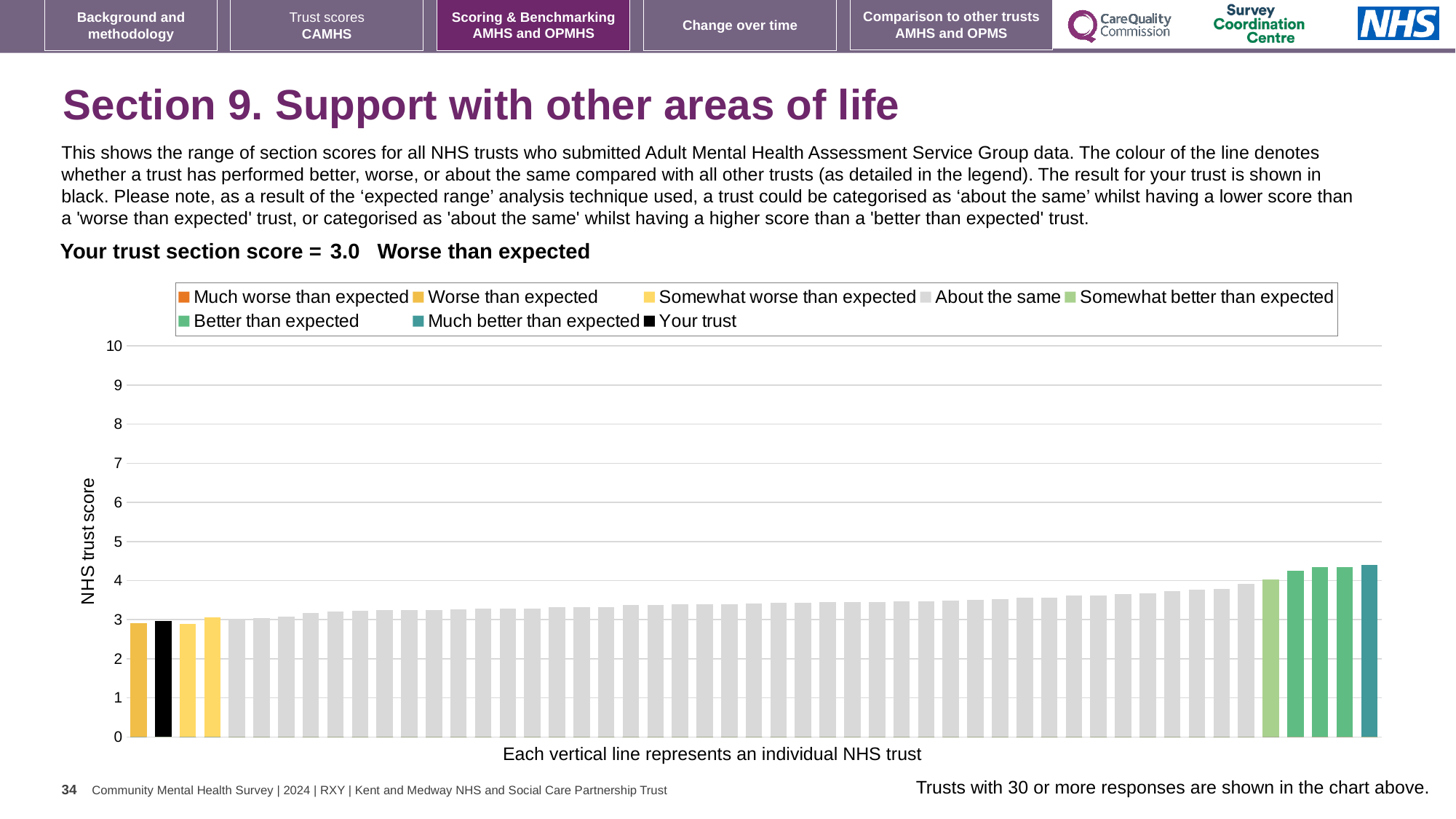
How many bars are shown in the 'Much worse than expected' colour? 0 Is the value for 'Your trust' greater or less than 5? less What colour is used for 'Your trust' in the legend? black Which legend category does the tallest bar belong to? Much better than expected What is the section score for 'Your trust' shown on the slide? 3.0 What is the title of the vertical axis? NHS trust score How many entries does the chart legend list? 8 Is the tallest bar in the chart greater or less than 5? less Is the tallest bar in the chart greater or less than 4? greater What kind of chart is shown on the slide? bar chart Which legend category is 'Your trust' placed in according to the slide? Worse than expected Do the bar values rise or fall from left to right along the x axis? rise